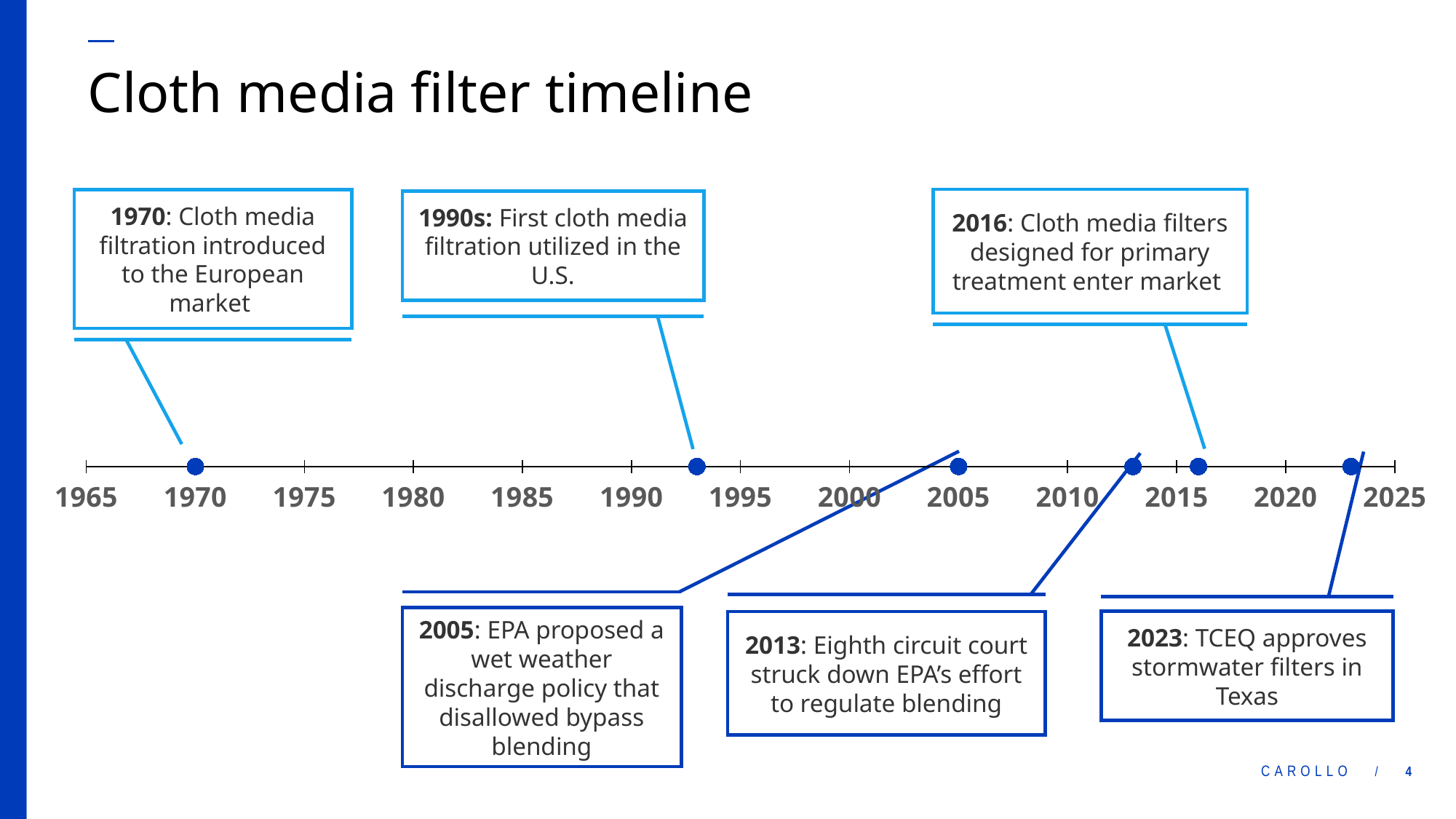
What is the title of the chart on the slide? Cloth media filter timeline What is the earliest year marked on the timeline? 1970 In what year was cloth media filtration introduced to the European market? 1970 How many years separate the first event (1970) and the last event (2023) on the timeline? 53 Which came earlier: the EPA proposed wet weather discharge policy or the Eighth circuit court striking down EPA's effort to regulate blending? EPA proposed wet weather discharge policy Is the point for the first cloth media filtration utilized in the U.S. placed before or after 1990 on the axis? after How many years separate the EPA's proposed wet weather discharge policy (2005) and the Eighth circuit court ruling (2013)? 8 In what year did TCEQ approve stormwater filters in Texas? 2023 How many events are marked with points on the timeline? 6 What kind of chart is shown on the slide? Timeline What event is marked at 2016 on the timeline? Cloth media filters designed for primary treatment enter market What is the latest year marked on the timeline? 2023